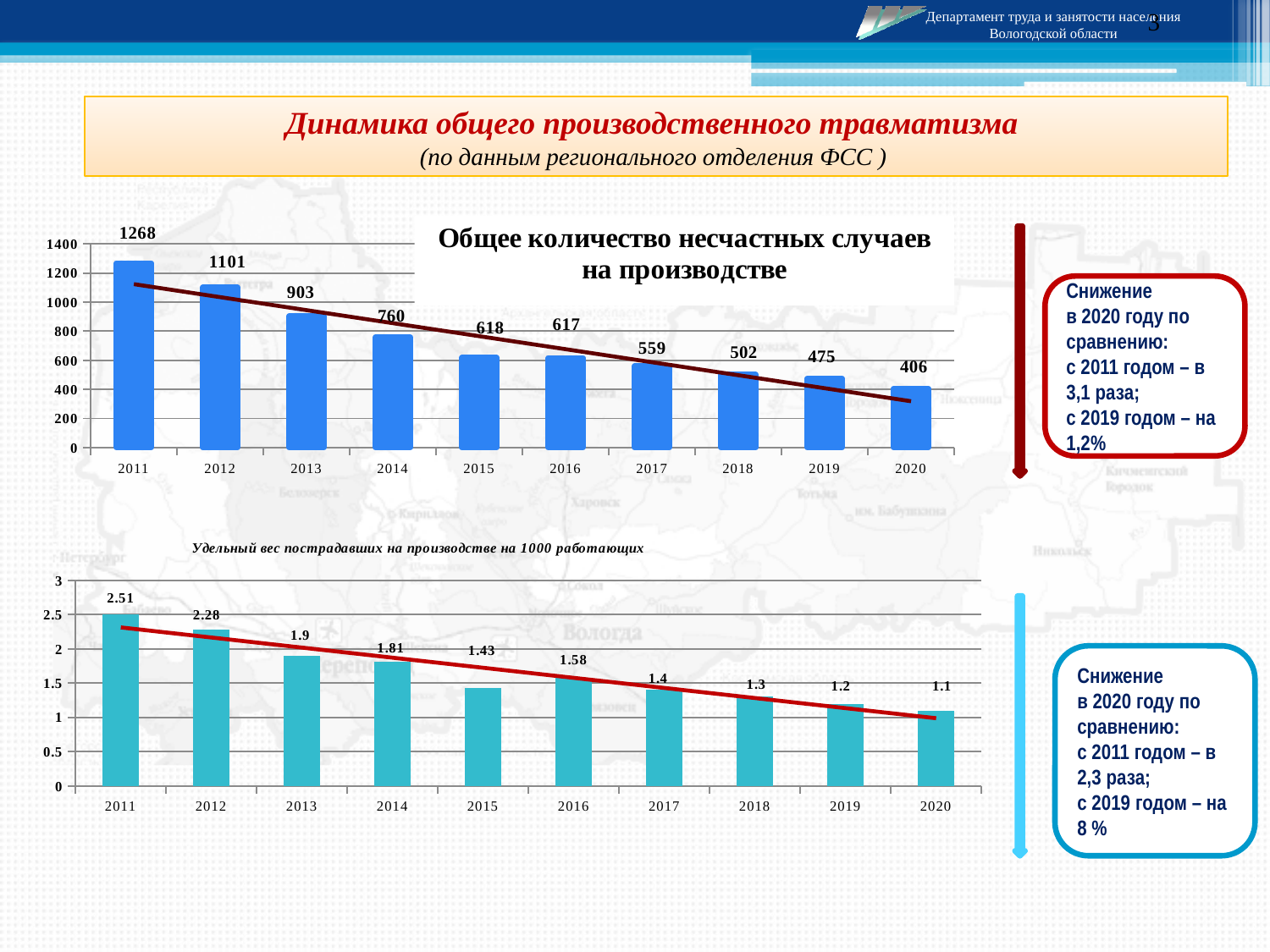
What kind of chart is the top chart 'Общее количество несчастных случаев на производстве'? bar chart In the chart 'Удельный вес пострадавших на производстве на 1000 работающих', which is larger, the value for 2015 or the value for 2016? 2016 In the chart 'Общее количество несчастных случаев на производстве', what is the value for 2017? 559 In the chart 'Удельный вес пострадавших на производстве на 1000 работающих', what is the difference between the values for 2011 and 2012? 0.23 In the chart 'Общее количество несчастных случаев на производстве', what is the value for 2011? 1268 In the chart 'Удельный вес пострадавших на производстве на 1000 работающих', what is the value for 2020? 1.1 In the chart 'Общее количество несчастных случаев на производстве', which year has the lowest value? 2020 In the chart 'Удельный вес пострадавших на производстве на 1000 работающих', what is the value for 2013? 1.9 In the chart 'Общее количество несчастных случаев на производстве', how many years are shown on the x axis? 10 In the chart 'Удельный вес пострадавших на производстве на 1000 работающих', which year has the highest value? 2011 In the chart 'Общее количество несчастных случаев на производстве', do the values generally rise or fall from 2011 to 2020? fall In the chart 'Общее количество несчастных случаев на производстве', what is the difference between the values for 2011 and 2020? 862